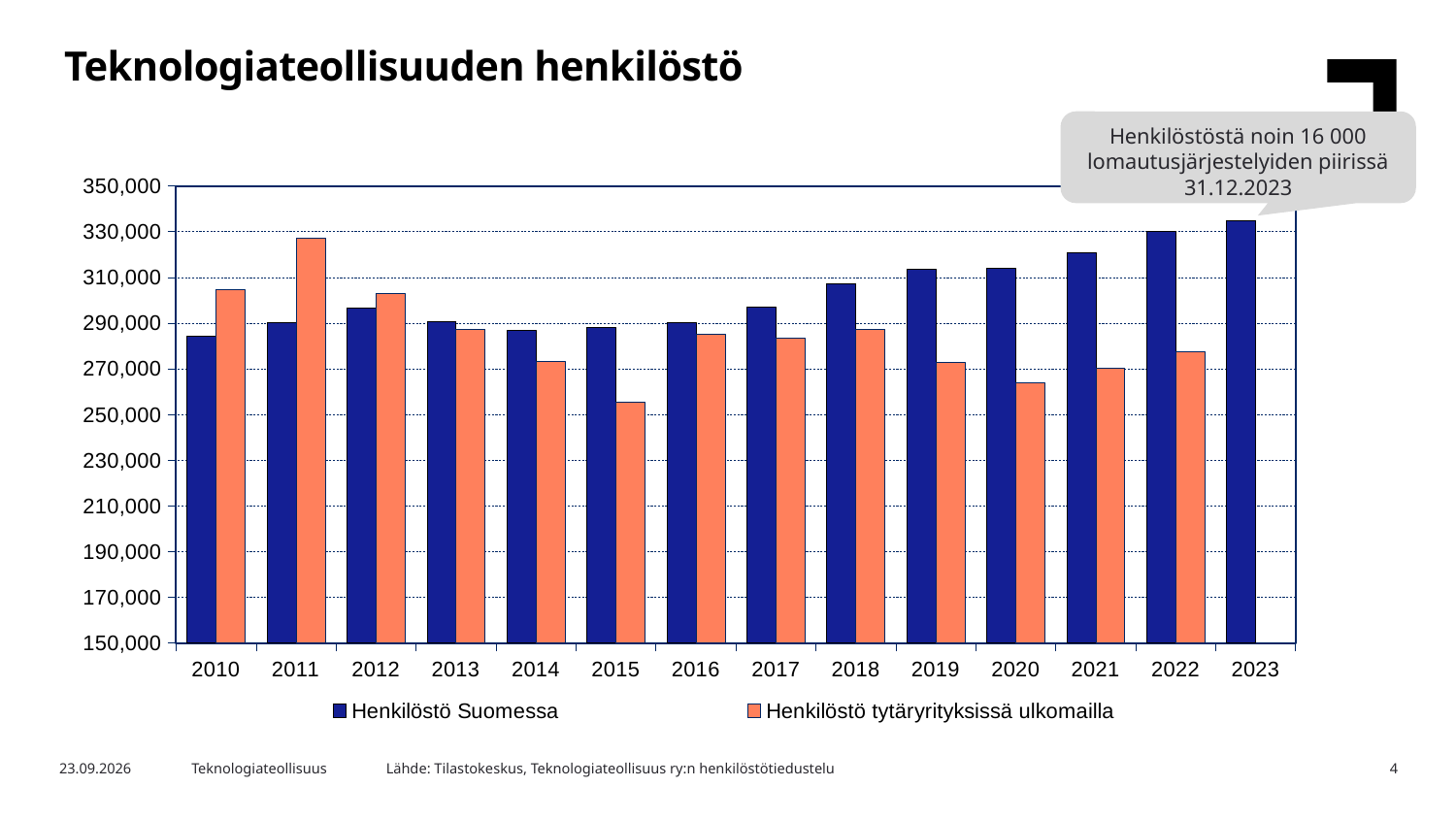
In 2011, which is larger: Henkilöstö Suomessa or Henkilöstö tytäryrityksissä ulkomailla? Henkilöstö tytäryrityksissä ulkomailla Do the values for Henkilöstö Suomessa rise or fall from 2016 to 2023? rise What is the title of the chart? Teknologiateollisuuden henkilöstö In which year is the value for Henkilöstö Suomessa highest? 2023 How many years are shown on the x axis? 14 Is the value for Henkilöstö Suomessa in 2010 greater or less than 290,000? less In which year is the value for Henkilöstö tytäryrityksissä ulkomailla highest? 2011 In which year is the value for Henkilöstö tytäryrityksissä ulkomailla lowest? 2015 Is the value for Henkilöstö tytäryrityksissä ulkomailla in 2015 greater or less than 270,000? less What kind of chart is shown on the slide? bar chart How many series does the legend list? 2 Is the value for Henkilöstö Suomessa in 2023 greater or less than 330,000? greater